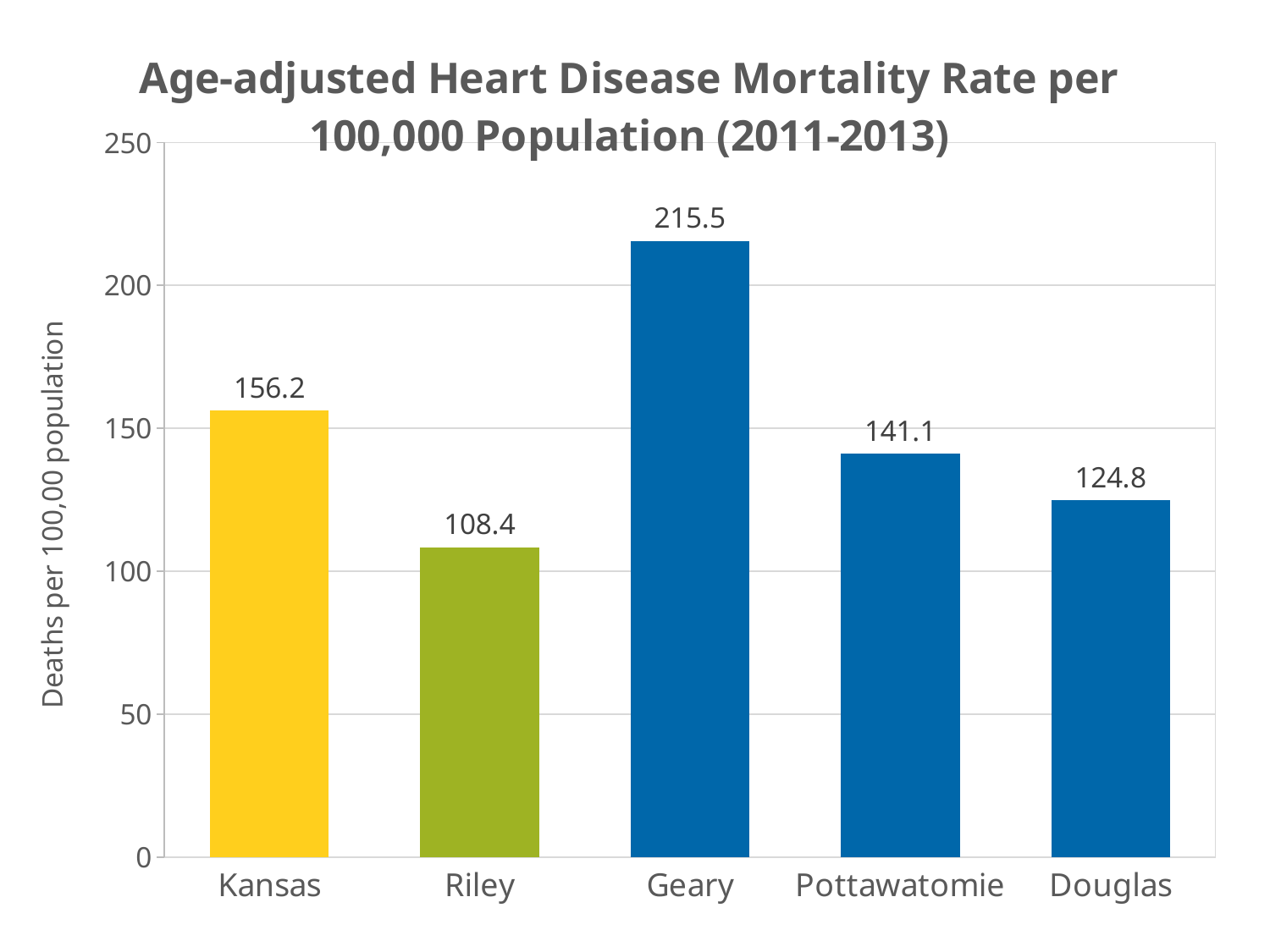
What kind of chart is shown on the slide? Bar chart Which category has the highest heart disease mortality rate? Geary What is the label of the vertical axis? Deaths per 100,00 population Is the value for Geary greater or less than 200? greater Which has a higher heart disease mortality rate, Kansas or Douglas? Kansas Which category has the lowest heart disease mortality rate? Riley What is the age-adjusted heart disease mortality rate for Kansas? 156.2 What is the age-adjusted heart disease mortality rate for Pottawatomie? 141.1 What is the difference between the mortality rates for Geary and Kansas? 59.3 What is the age-adjusted heart disease mortality rate for Riley? 108.4 What is the difference between the mortality rates for Pottawatomie and Douglas? 16.3 How many categories are shown on the x axis? 5